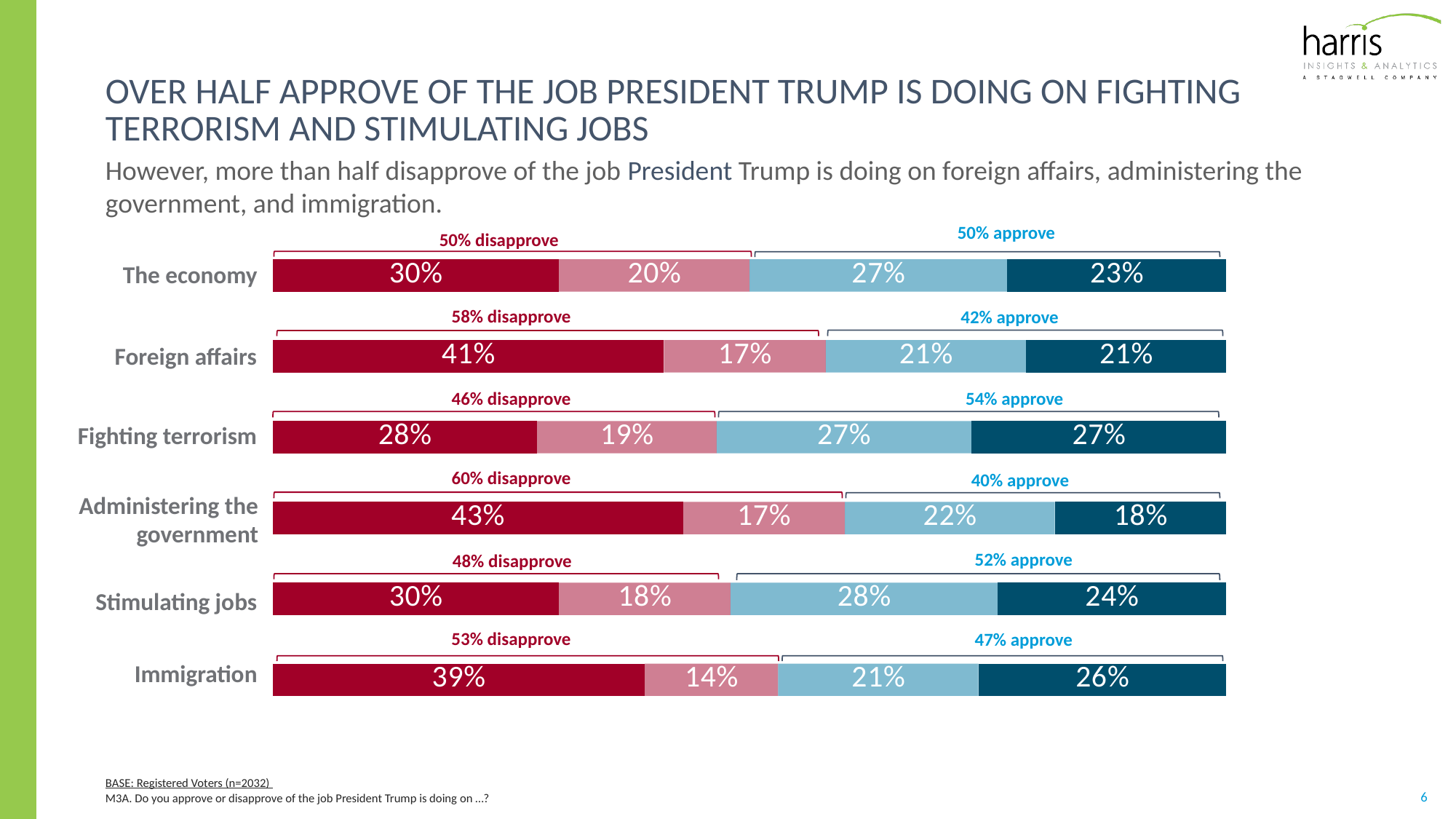
How many issue categories are plotted in the chart? 6 What is the total approve percentage shown for Fighting terrorism? 54% For Foreign affairs, how many percentage points higher is the disapprove total than the approve total? 16 Which category has the lowest total approve percentage? Administering the government What value is shown in the dark blue (rightmost) segment of the Stimulating jobs bar? 24% What value is shown in the dark red (leftmost) segment of the Immigration bar? 39% What kind of chart is shown on the slide? Stacked bar chart Which is larger: the dark red (leftmost) segment for Foreign affairs or the dark red (leftmost) segment for Immigration? Foreign affairs What is the sum of the two blue segments in the Immigration bar? 47% Which category has the highest total disapprove percentage? Administering the government How many coloured segments make up each bar in the chart? 4 What is the total disapprove percentage shown for Administering the government? 60%